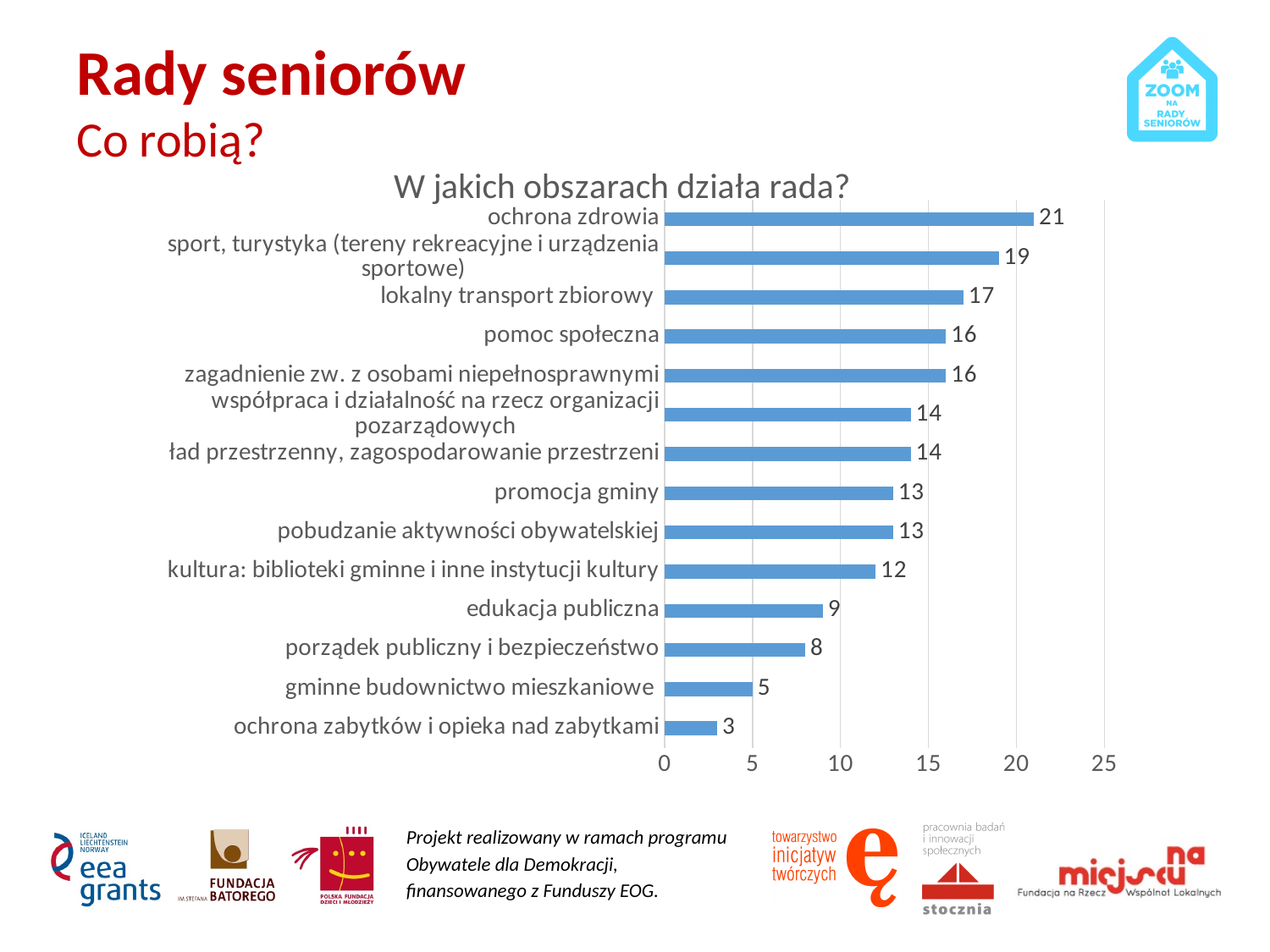
What is the value for "gminne budownictwo mieszkaniowe"? 5 How many categories are shown in the chart? 14 What is the value for "ochrona zdrowia"? 21 What is the difference between the values for "kultura: biblioteki gminne i inne instytucji kultury" and "ochrona zabytków i opieka nad zabytkami"? 9 What is the value for "lokalny transport zbiorowy"? 17 Which is larger: the value for "edukacja publiczna" or the value for "porządek publiczny i bezpieczeństwo"? edukacja publiczna What is the title of the chart? W jakich obszarach działa rada? Is the value for "pomoc społeczna" greater or less than 15? greater What is the difference between the values for "ochrona zdrowia" and "sport, turystyka (tereny rekreacyjne i urządzenia sportowe)"? 2 Which category has the highest value? ochrona zdrowia What kind of chart is shown on the slide? bar chart Which category has the lowest value? ochrona zabytków i opieka nad zabytkami